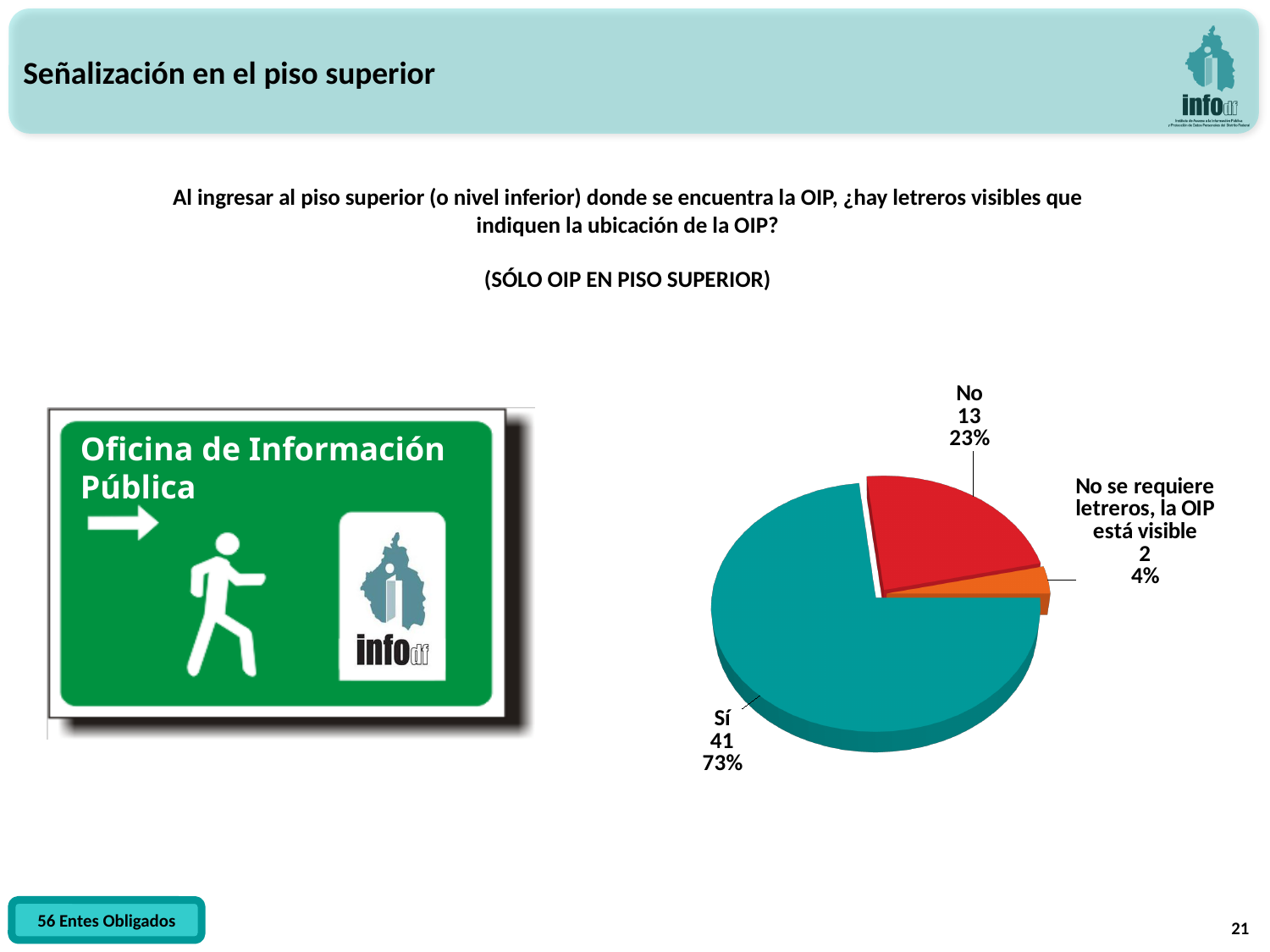
How many slices does the pie chart have? 3 What kind of chart is shown on the slide? pie chart Which category has the largest slice? Sí What is the difference between the counts for "Sí" and "No"? 28 What percentage does the "Sí" slice represent? 73% What percentage does the "No" slice represent? 23% Which is larger, the count for "No" or the count for "No se requiere letreros, la OIP está visible"? No Which category has the smallest slice? No se requiere letreros, la OIP está visible What is the count for the "No se requiere letreros, la OIP está visible" slice? 2 What colour is the "Sí" slice? teal What is the count for the "Sí" slice? 41 What is the total of the three counts shown on the pie chart? 56